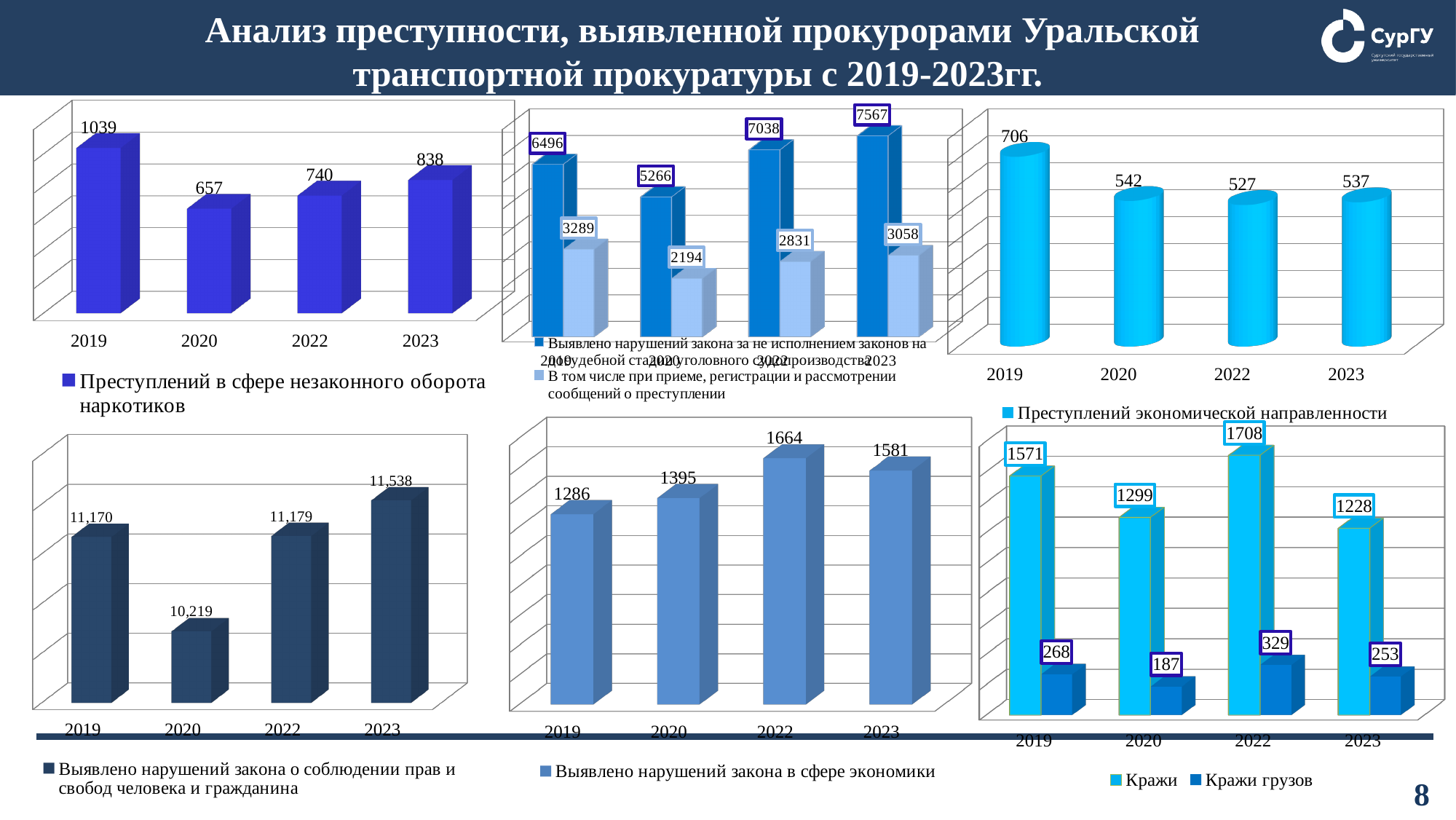
In the top-right chart (Преступлений экономической направленности), what is the value for 2022? 527 How many year categories are shown on the x axis of the bottom-right chart (Кражи / Кражи грузов)? 4 In the bottom-middle chart (Выявлено нарушений закона в сфере экономики), which is larger: the value for 2022 or the value for 2023? 2022 In the top-left chart (Преступлений в сфере незаконного оборота наркотиков), what is the value for 2019? 1039 In the bottom-right chart, what is the value of Кражи грузов for 2022? 329 How many series does the legend of the top-middle chart list? 2 In the top-right chart (Преступлений экономической направленности), which year has the highest value? 2019 In the bottom-middle chart (Выявлено нарушений закона в сфере экономики), what is the difference between the 2022 value and the 2019 value? 378 In the top-middle chart, what is the difference between the two series' values for 2020 (5266 and 2194)? 3072 In the top-middle chart, what is the value of the darker series (Выявлено нарушений закона за не исполнением законов на досудебной стадии уголовного судопроизводства) for 2023? 7567 In the top-left chart (Преступлений в сфере незаконного оборота наркотиков), which year has the lowest value? 2020 In the bottom-left chart (Выявлено нарушений закона о соблюдении прав и свобод человека и гражданина), what is the value for 2023? 11,538